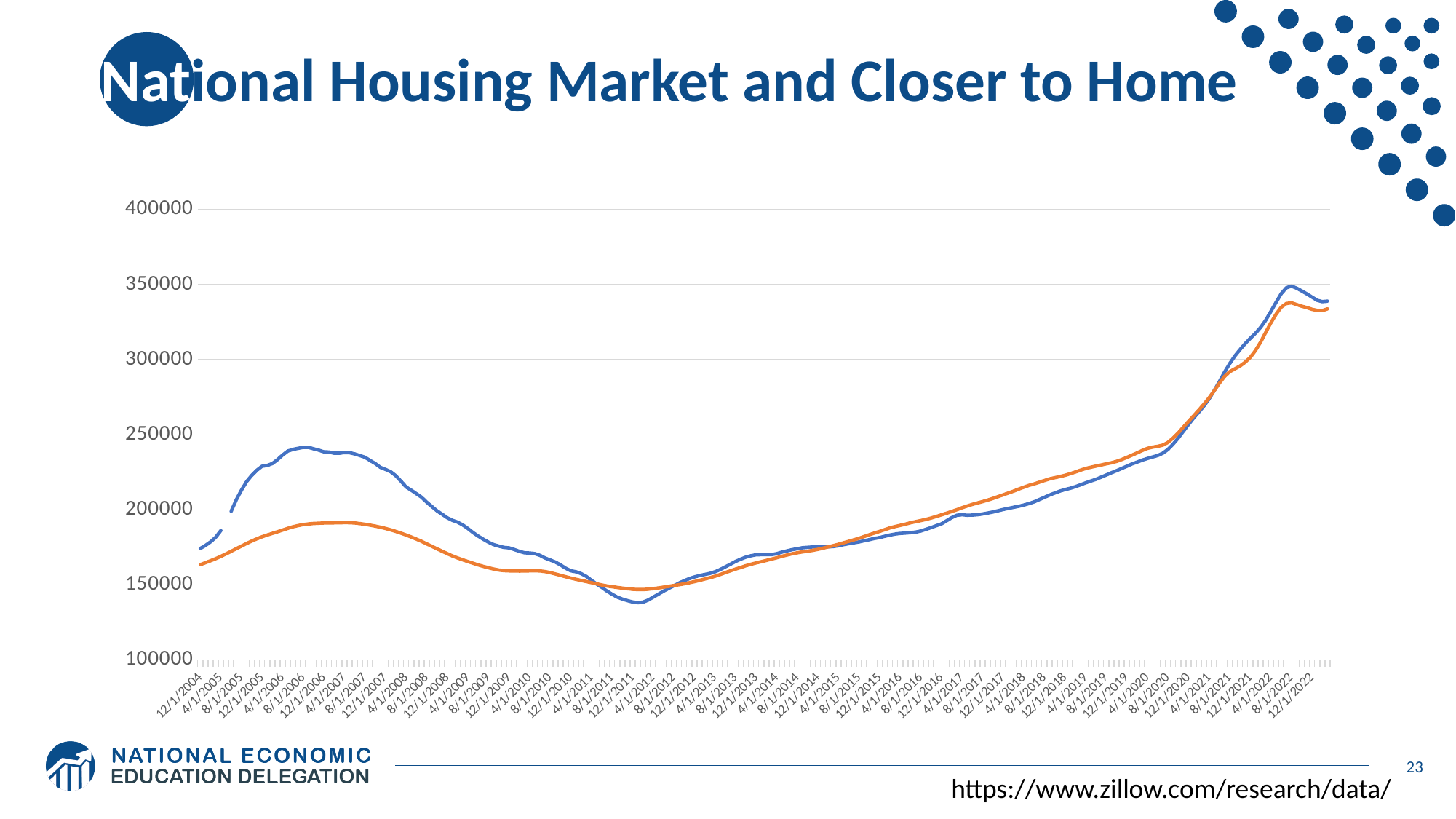
What is the title of the slide containing the chart? National Housing Market and Closer to Home Is the value of the orange line at 12/1/2022 greater or less than 300000? greater What is the highest value shown on the chart's vertical axis? 400000 Is the value of the blue line at 12/1/2004 greater or less than 200000? less At 4/1/2022, which line has the higher value, the blue line or the orange line? blue line What kind of chart is shown on the slide? line chart How many lines are plotted on the chart? 2 Is the value of the blue line at 4/1/2006 greater or less than 200000? greater At 12/1/2004, which line has the higher value, the blue line or the orange line? blue line Between 12/1/2011 and 4/1/2022, do the values of the blue line generally rise or fall? rise